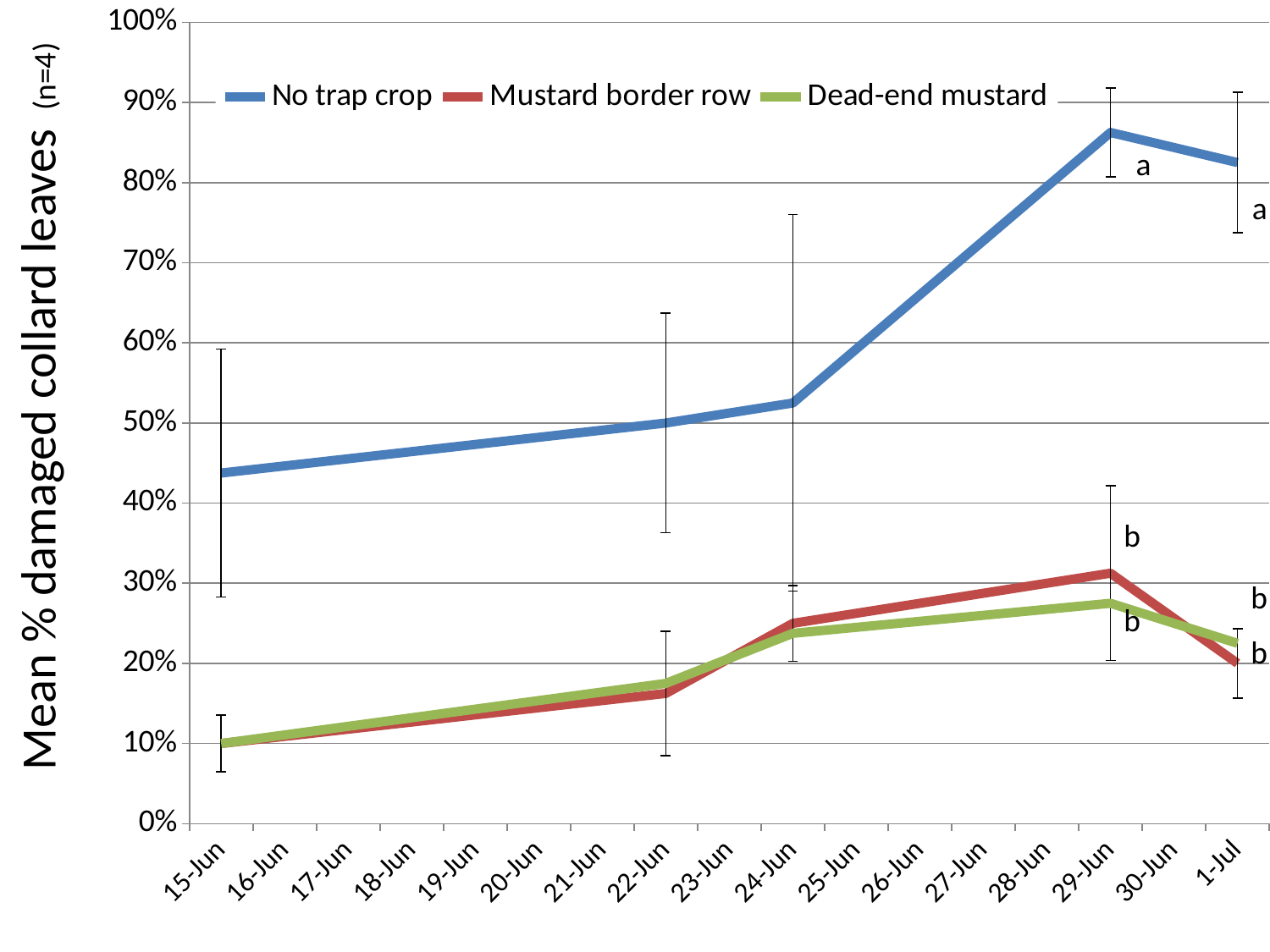
How many series does the legend list? 3 Does the Mustard border row series rise or fall from 29-Jun to 1-Jul? fall Is the value for Mustard border row on 1-Jul greater or less than 30%? less On 29-Jun, which is larger: the value for No trap crop or the value for Mustard border row? No trap crop Is the value for Dead-end mustard on 15-Jun greater or less than 20%? less What is the title of the y axis? Mean % damaged collard leaves (n=4) Does the No trap crop series rise or fall from 15-Jun to 29-Jun? rise What kind of chart is shown on the slide? line chart Which series has the highest value on 1-Jul? No trap crop Is the value for No trap crop on 29-Jun greater or less than 80%? greater What are the three series named in the legend? No trap crop, Mustard border row, Dead-end mustard